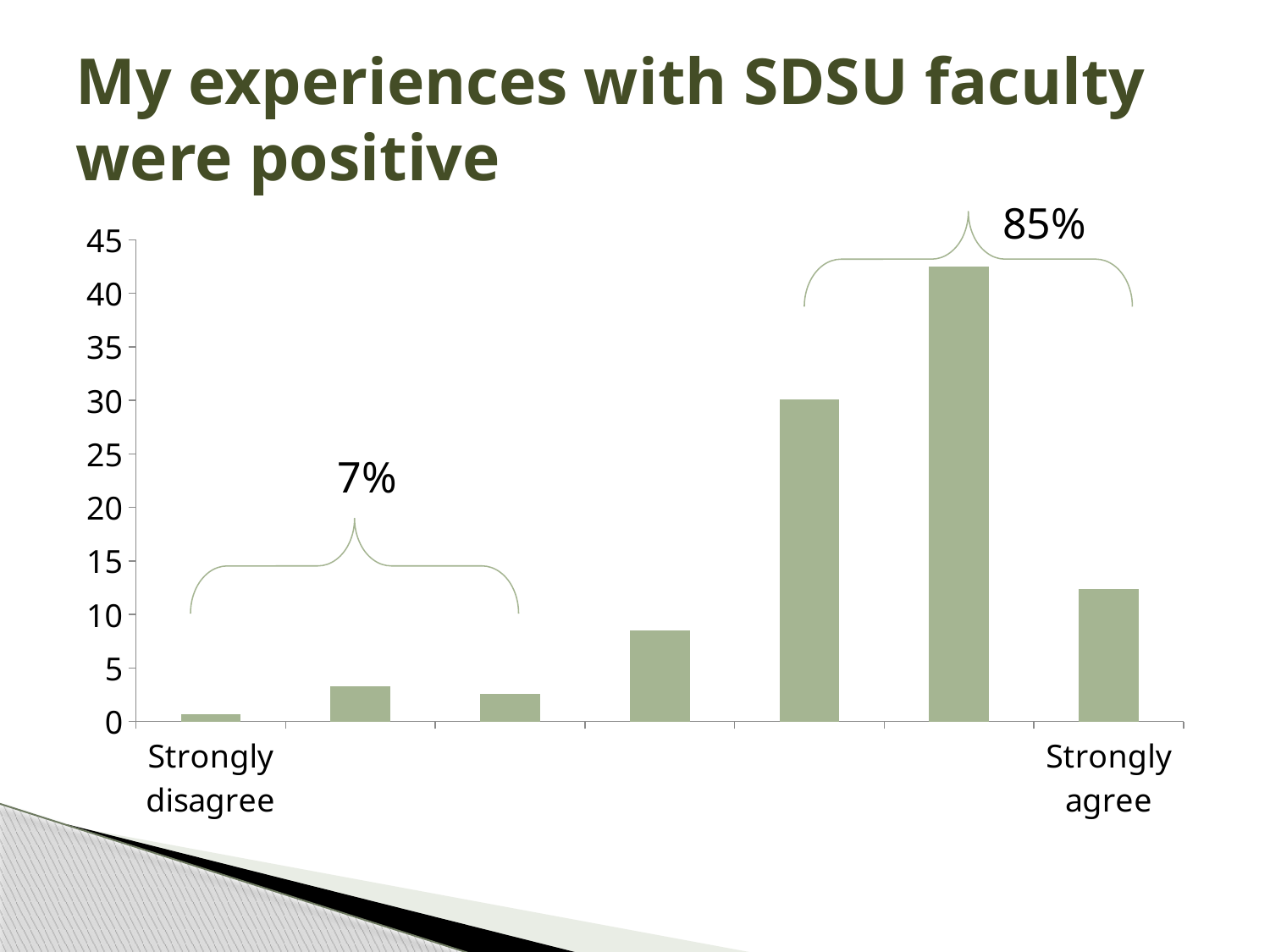
Is the value for Strongly disagree greater or less than 5? less Is the tallest bar in the chart greater or less than 40? greater What kind of chart is shown on the slide? bar chart Which is larger, the value for Strongly agree or the value for Strongly disagree? Strongly agree Is the value for Strongly agree greater or less than 10? greater What percentage is written above the bracket spanning the three bars on the right of the chart? 85% Which bar is taller: the Strongly agree bar or the bar immediately to its left? the bar immediately to its left What percentage is written above the bracket spanning the three bars on the left of the chart? 7% How many bars are plotted in the chart? 7 Which of the two labelled categories, Strongly disagree or Strongly agree, has the lowest value? Strongly disagree